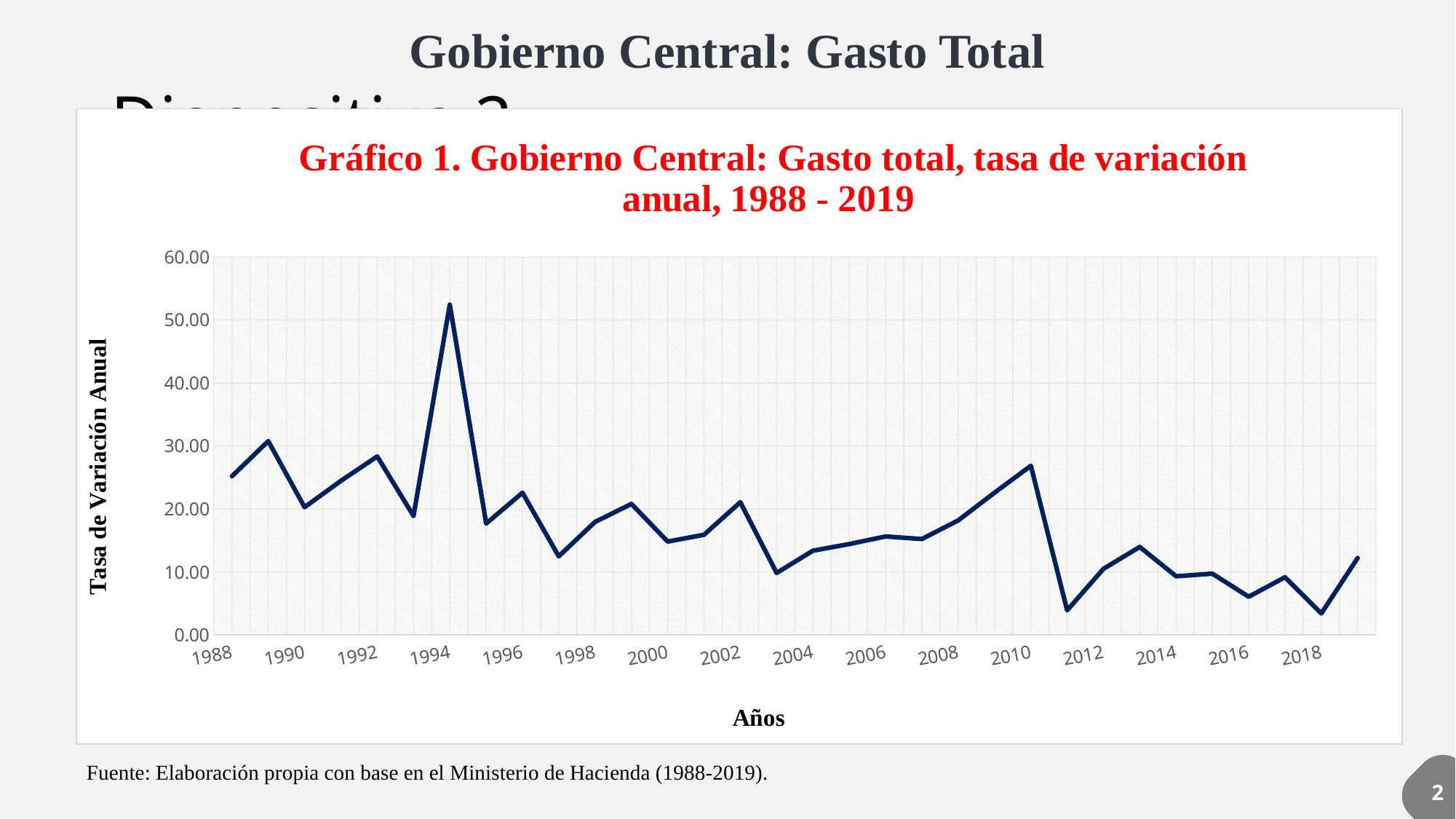
Is the value for 1997 greater or less than 20.00? less Does the line rise or fall between 2010 and 2011? fall What kind of chart is shown on the slide? line chart In which year does the annual variation rate reach its highest value? 1994 Is the value for 2011 greater or less than 10.00? less Is the value for 2010 greater or less than 20.00? greater What is the label of the vertical axis? Tasa de Variación Anual How many years are plotted on the chart? 32 Which year has the larger value, 1995 or 2010? 2010